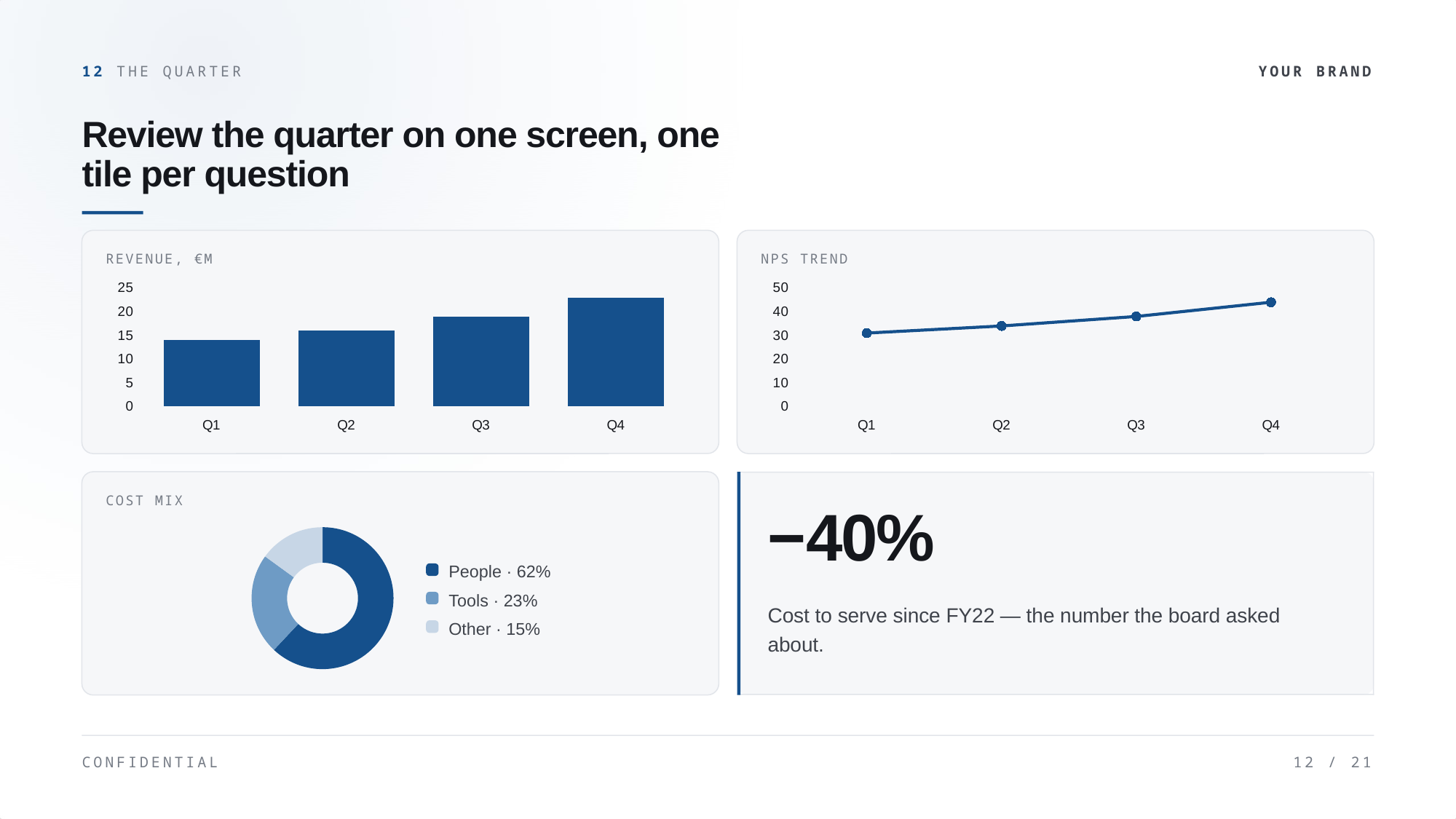
In the "NPS Trend" chart, which quarter has the lowest NPS? Q1 How many quarters are shown in the "Revenue, €M" chart? 4 In the "NPS Trend" chart, is the value for Q4 greater or less than 40? greater In the "Revenue, €M" chart, which quarter has the lowest revenue? Q1 In the "Cost Mix" chart, which category has the largest share? People What kind of chart is the "Revenue, €M" chart? bar chart In the "NPS Trend" chart, do the values rise or fall from Q1 to Q4? rise In the "Cost Mix" chart, what share of costs is Tools? 23% In the "Revenue, €M" chart, which quarter has the highest revenue? Q4 In the "Revenue, €M" chart, is the value for Q4 greater or less than 20? greater What kind of chart is the "NPS Trend" chart? line chart